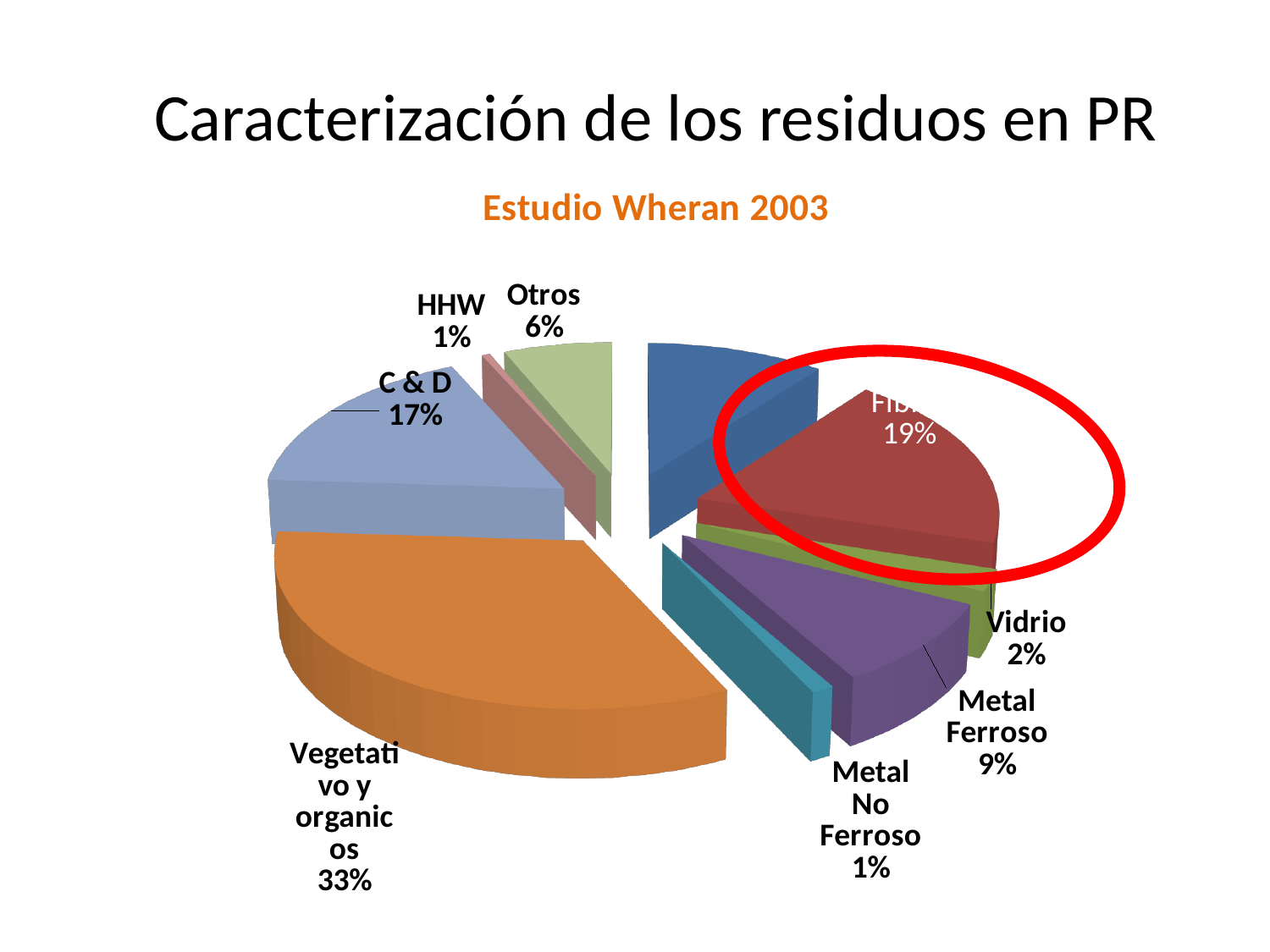
What is the difference in percentage points between C & D and Otros? 11 percentage points What is the difference in percentage points between Vegetativo y organicos and C & D? 16 percentage points What percentage is shown for Otros? 6% Which is larger, the share for C & D or the share for Metal Ferroso? C & D What percentage is shown for Metal No Ferroso? 1% Which category has the largest slice of the pie? Vegetativo y organicos What percentage is shown for Vidrio? 2% What kind of chart is shown on the slide? Pie chart What percentage is shown for C & D? 17% What is the title of the chart? Estudio Wheran 2003 What share of the pie does Vegetativo y organicos represent? 33% What percentage is shown for Metal Ferroso? 9%